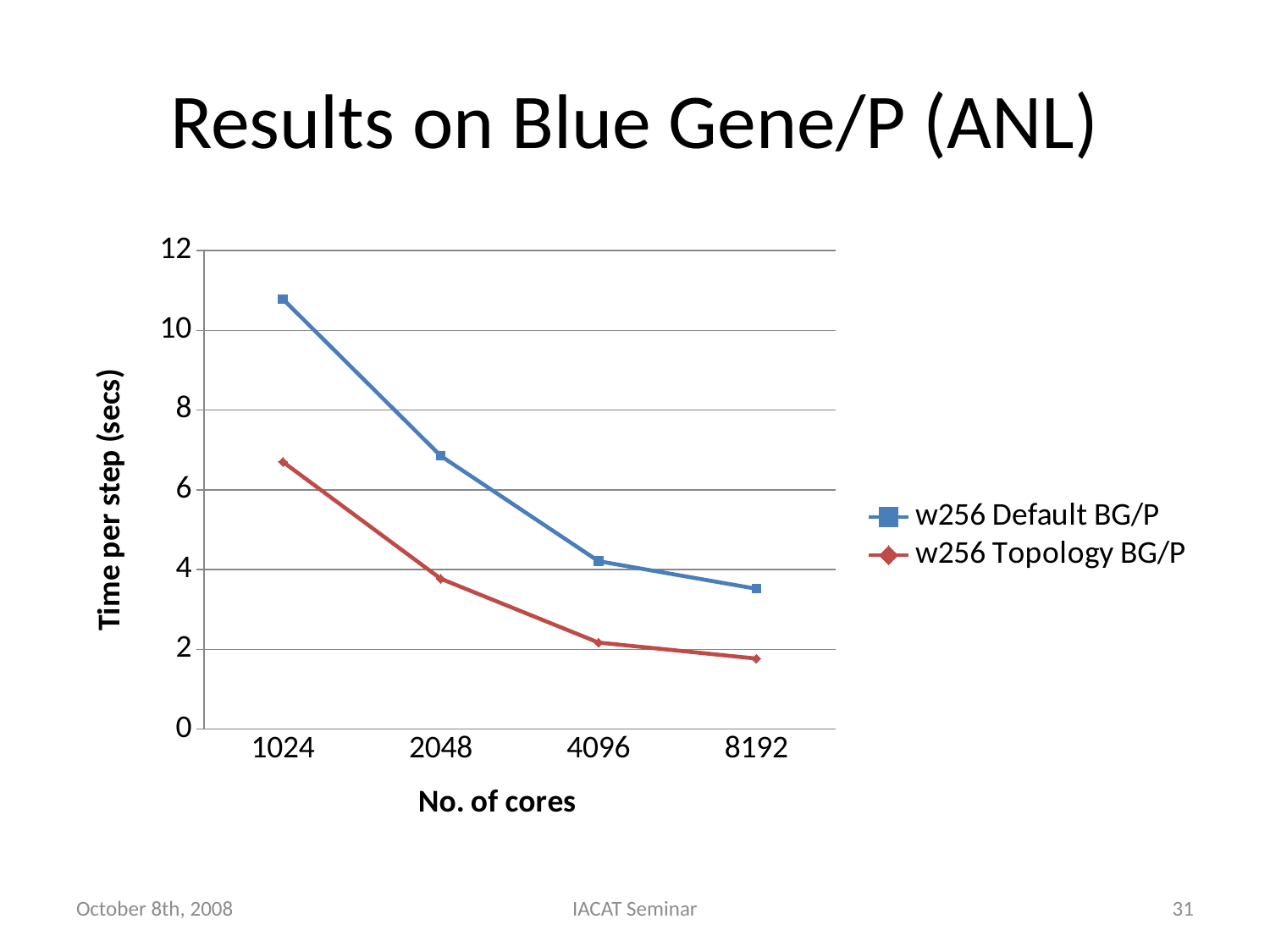
What is the label of the y axis? Time per step (secs) Do the values for w256 Topology BG/P rise or fall as the number of cores increases? fall What kind of chart is shown on the slide? line chart How many points are plotted along the x axis for each series? 4 Do the values for w256 Default BG/P rise or fall as the number of cores increases? fall How many series does the legend list? 2 Is the value for w256 Topology BG/P at 2048 cores greater or less than 4? less Is the value for w256 Default BG/P at 4096 cores greater or less than 4? greater At 2048 cores, which series has the larger time per step, w256 Default BG/P or w256 Topology BG/P? w256 Default BG/P At which number of cores is the time per step for w256 Default BG/P highest? 1024 At which number of cores is the time per step for w256 Topology BG/P lowest? 8192 Is the value for w256 Default BG/P at 1024 cores greater or less than 10? greater